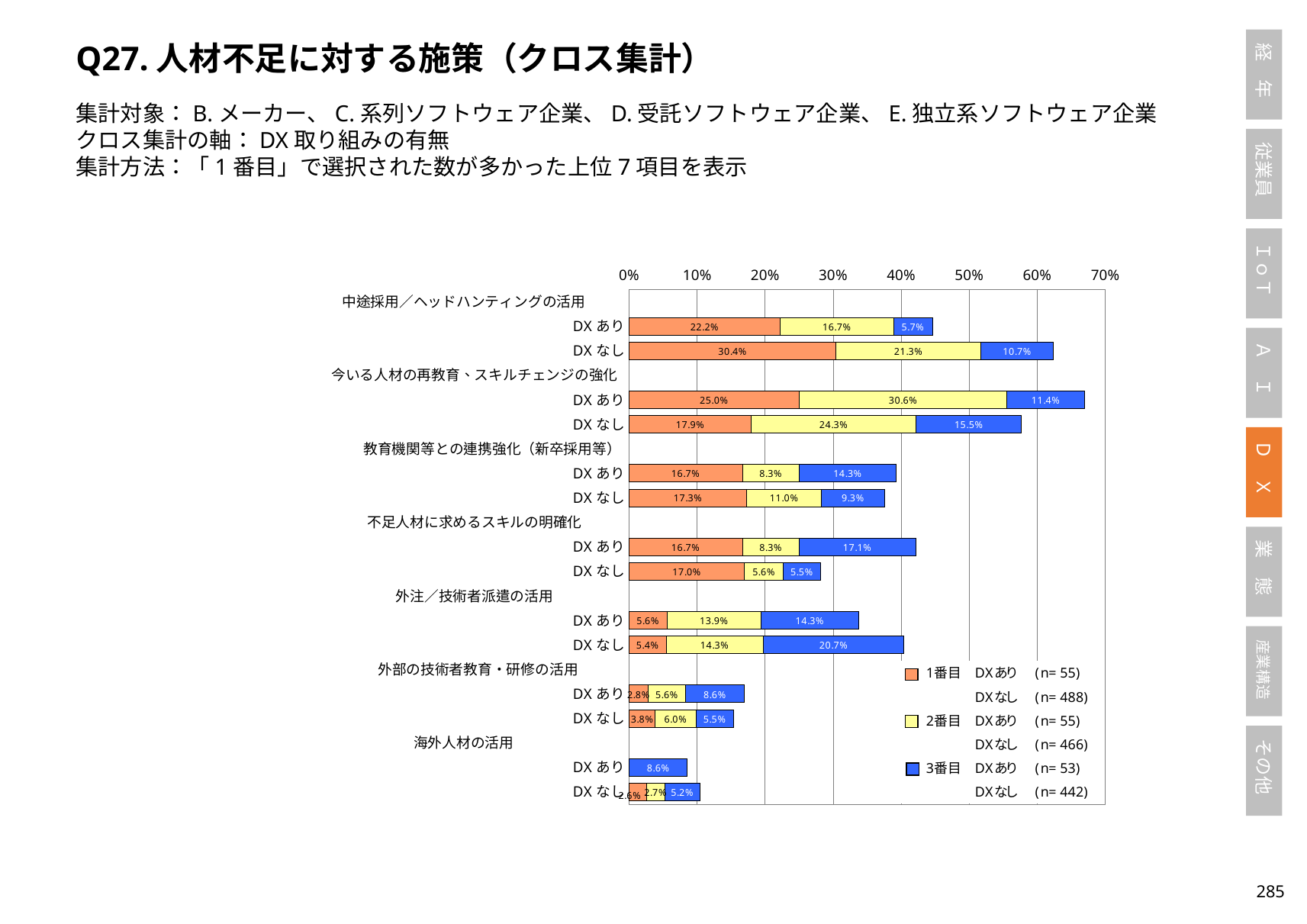
What is the total of the stacked bar for DXあり under 今いる人材の再教育、スキルチェンジの強化? 67.0% What is the 1番目 value for DXなし under 中途採用／ヘッドハンティングの活用? 30.4% Is the total stacked bar for DXなし under 今いる人材の再教育、スキルチェンジの強化 greater or less than 50%? greater What is the sample size (n) shown in the legend for 1番目 DXなし? 488 What is the 3番目 value for DXあり under 海外人材の活用? 8.6% What is the difference between the 1番目 values for DXなし and DXあり under 中途採用／ヘッドハンティングの活用? 8.2% Which is larger: the 3番目 value for DXあり or for DXなし under 不足人材に求めるスキルの明確化? DXあり What is the 2番目 value for DXあり under 今いる人材の再教育、スキルチェンジの強化? 30.6% What is the 3番目 value for DXなし under 外注／技術者派遣の活用? 20.7% What kind of chart is shown on the slide? Stacked bar chart What is the total of the stacked bar for DXなし under 中途採用／ヘッドハンティングの活用? 62.4% How many series does the legend list? 3